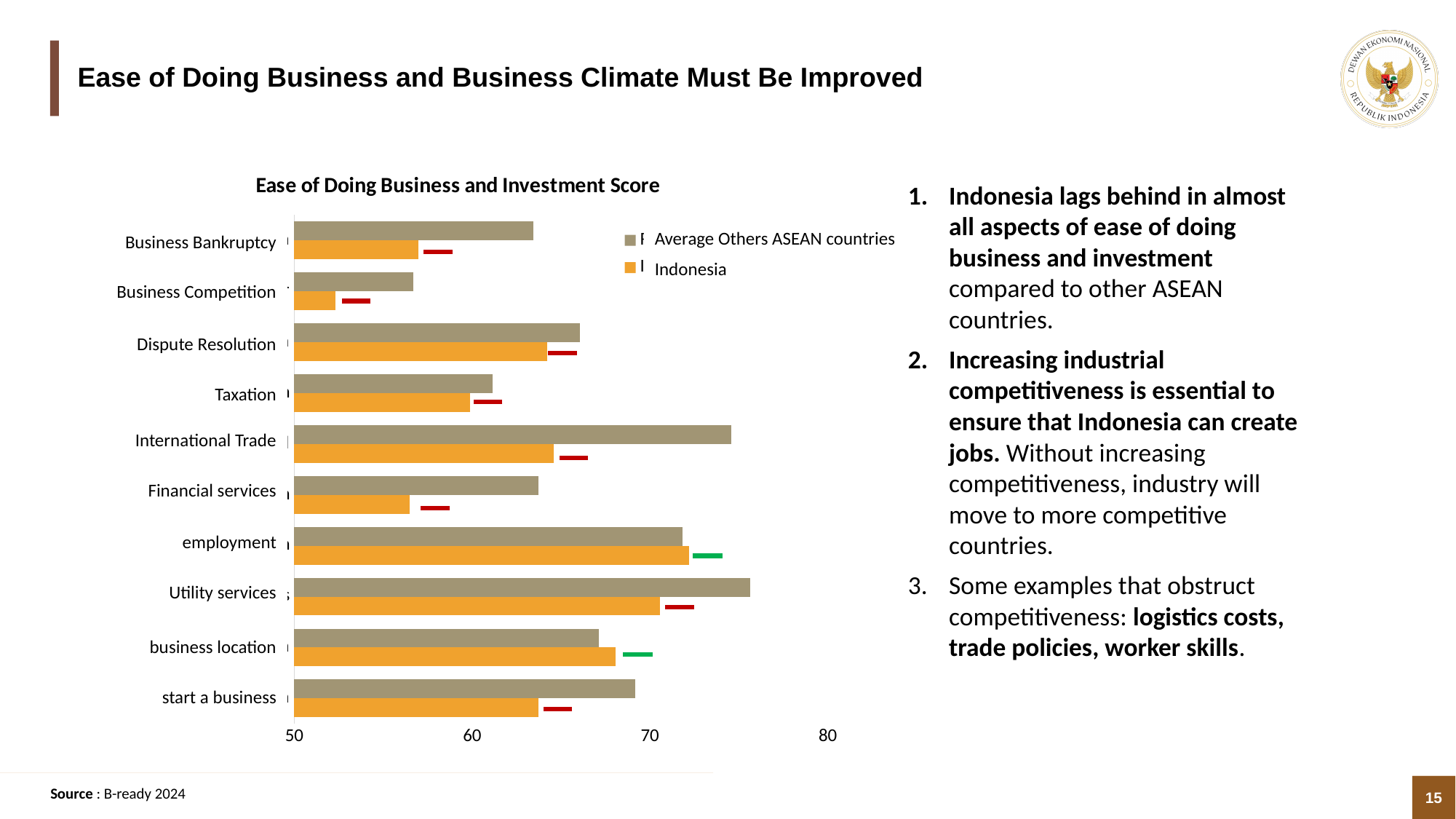
How many categories are plotted in the chart? 10 For International Trade, which is larger: the Indonesia score or the Average Others ASEAN countries score? Average Others ASEAN countries What is the title of the chart? Ease of Doing Business and Investment Score Is the Indonesia value for employment greater or less than 70? greater Is the Indonesia value for Business Competition greater or less than 60? less Which category has the lowest Average Others ASEAN countries score? Business Competition Is the Average Others ASEAN countries value for International Trade greater or less than 70? greater Which category has the lowest Indonesia score? Business Competition How many series does the chart legend list? 2 What kind of chart is shown on the slide? Bar chart Which colour represents Indonesia in the chart? Orange